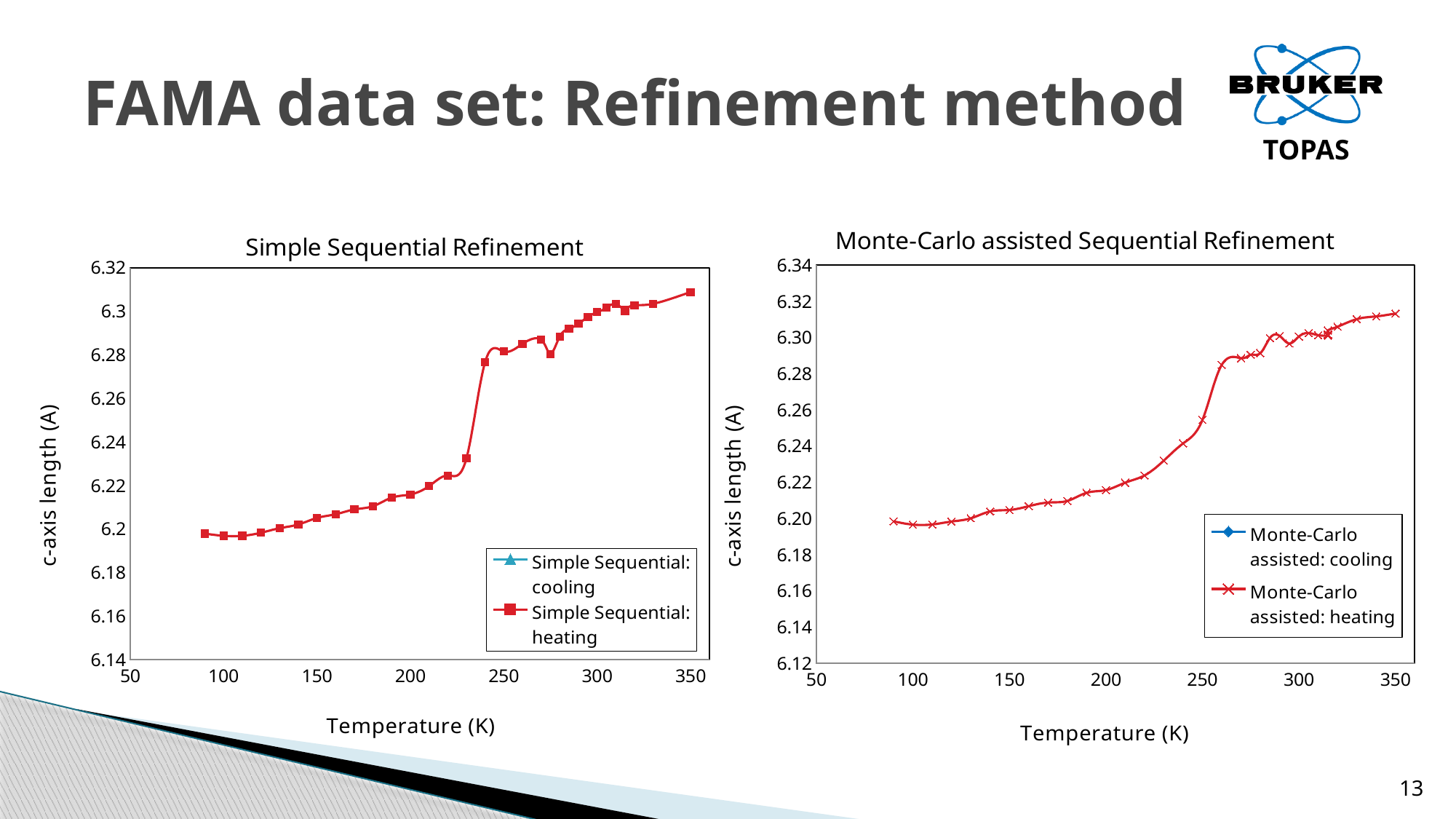
What is the y-axis label of the 'Simple Sequential Refinement' chart? c-axis length (A) How many series does the legend of the 'Monte-Carlo assisted Sequential Refinement' chart list? 2 In the 'Monte-Carlo assisted Sequential Refinement' chart, is the c-axis length larger at 250 K or at 100 K? 250 K In the 'Simple Sequential Refinement' chart, is the c-axis length at 200 K greater or less than 6.24? less In the 'Monte-Carlo assisted Sequential Refinement' chart, is the c-axis length at 300 K greater or less than 6.28? greater In the 'Monte-Carlo assisted Sequential Refinement' chart, does the c-axis length rise or fall overall as temperature increases? rise In the 'Monte-Carlo assisted Sequential Refinement' chart, is the c-axis length at 150 K greater or less than 6.22? less In the 'Simple Sequential Refinement' chart, does the c-axis length rise or fall as temperature increases from 100 K to 350 K? rise What kind of chart is the 'Simple Sequential Refinement' chart? line chart In the 'Simple Sequential Refinement' chart, which temperature has the highest c-axis length? 350 K How many series does the legend of the 'Simple Sequential Refinement' chart list? 2